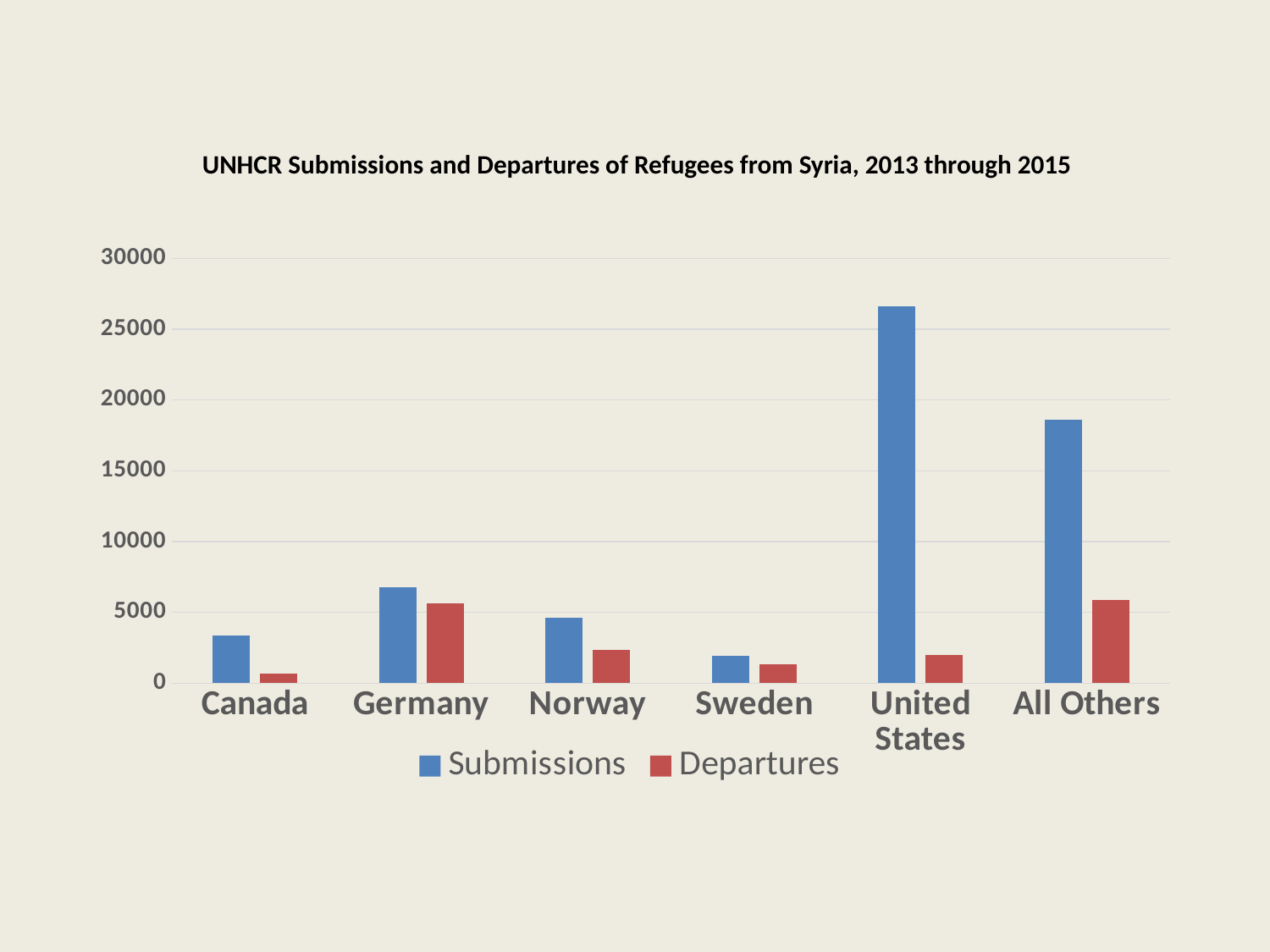
Is the Submissions value for All Others greater or less than 20000? less Is the Submissions value for United States greater or less than 25000? greater What kind of chart is shown on the slide? bar chart How many series does the legend list? 2 Which category has the lowest Departures value? Canada Is the Departures value for Canada greater or less than 5000? less What is the title of the chart? UNHCR Submissions and Departures of Refugees from Syria, 2013 through 2015 Which is larger: the Submissions value for Germany or the Submissions value for Norway? Germany Which category has the lowest Submissions value? Sweden How many categories are shown on the x axis? 6 Which category has the highest Submissions value? United States